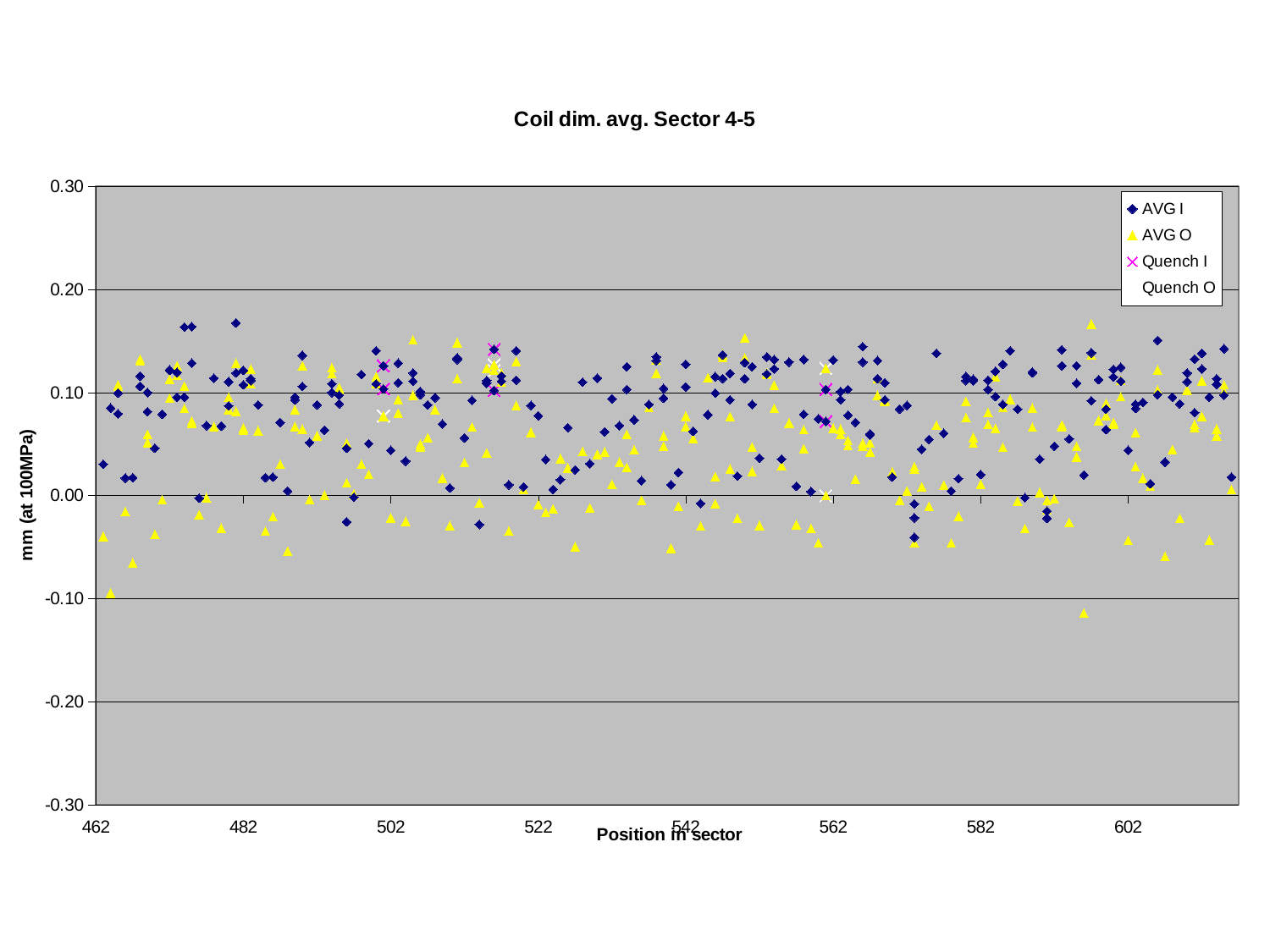
Which series contains the lowest plotted value on the chart? AVG O Is the lowest value for AVG O greater or less than -0.10? less Is the highest value for AVG O greater or less than 0.20? less What kind of chart is shown on the slide? scatter chart What is the label on the vertical axis? mm (at 100MPa) Is the highest value for AVG I greater or less than 0.20? less What is the title of the chart? Coil dim. avg. Sector 4-5 How many series does the legend list? 4